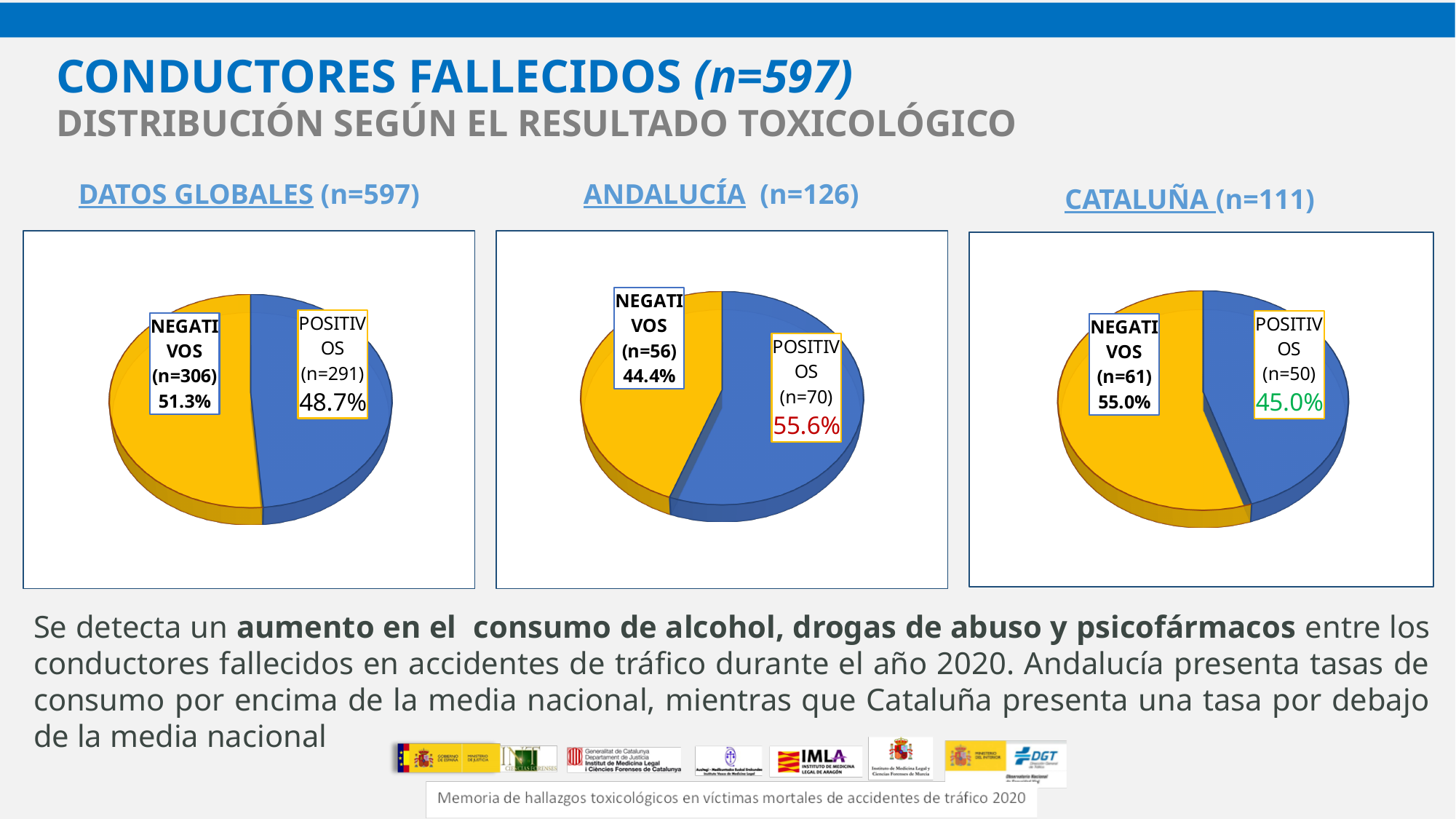
In the DATOS GLOBALES chart, how many drivers were POSITIVOS? n=291 In the CATALUÑA chart, how many drivers were POSITIVOS? n=50 In the DATOS GLOBALES chart, what is the difference in percentage points between NEGATIVOS and POSITIVOS? 2.6 In the CATALUÑA chart, which slice is the largest? NEGATIVOS What kind of chart is used for the ANDALUCÍA data? Pie chart In the DATOS GLOBALES chart, what percentage of drivers were NEGATIVOS? 51.3% In the CATALUÑA chart, what percentage of drivers were NEGATIVOS? 55.0% In the ANDALUCÍA chart, which slice is larger, NEGATIVOS or POSITIVOS? POSITIVOS In the ANDALUCÍA chart, how many drivers were NEGATIVOS? n=56 How many slices does the CATALUÑA pie chart have? 2 In the ANDALUCÍA chart, what percentage of drivers were POSITIVOS? 55.6% How many pie charts are shown on the slide? 3